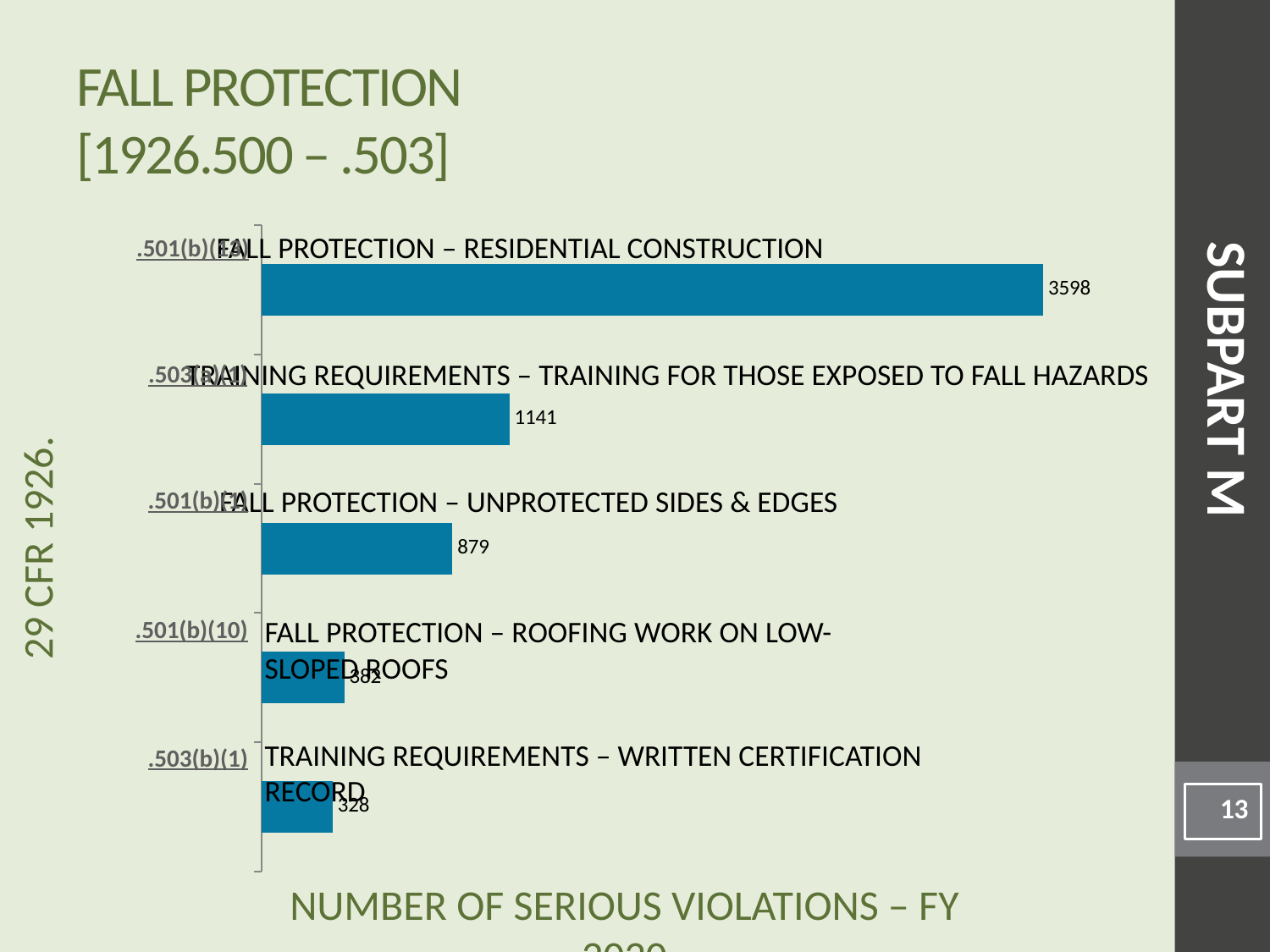
What is the difference in serious violations between FALL PROTECTION – RESIDENTIAL CONSTRUCTION and TRAINING REQUIREMENTS – TRAINING FOR THOSE EXPOSED TO FALL HAZARDS? 2457 Which category has the highest number of serious violations? FALL PROTECTION – RESIDENTIAL CONSTRUCTION What is the difference in serious violations between TRAINING REQUIREMENTS – TRAINING FOR THOSE EXPOSED TO FALL HAZARDS and FALL PROTECTION – UNPROTECTED SIDES & EDGES? 262 How many categories are plotted in the chart? 5 Which category has the lowest number of serious violations? TRAINING REQUIREMENTS – WRITTEN CERTIFICATION RECORD What kind of chart is shown on the slide? bar chart Which has more serious violations: FALL PROTECTION – UNPROTECTED SIDES & EDGES or FALL PROTECTION – ROOFING WORK ON LOW-SLOPED ROOFS? FALL PROTECTION – UNPROTECTED SIDES & EDGES What is the number of serious violations for FALL PROTECTION – RESIDENTIAL CONSTRUCTION? 3598 What is the number of serious violations for TRAINING REQUIREMENTS – WRITTEN CERTIFICATION RECORD? 328 What is the number of serious violations for TRAINING REQUIREMENTS – TRAINING FOR THOSE EXPOSED TO FALL HAZARDS? 1141 What is the number of serious violations for FALL PROTECTION – UNPROTECTED SIDES & EDGES? 879